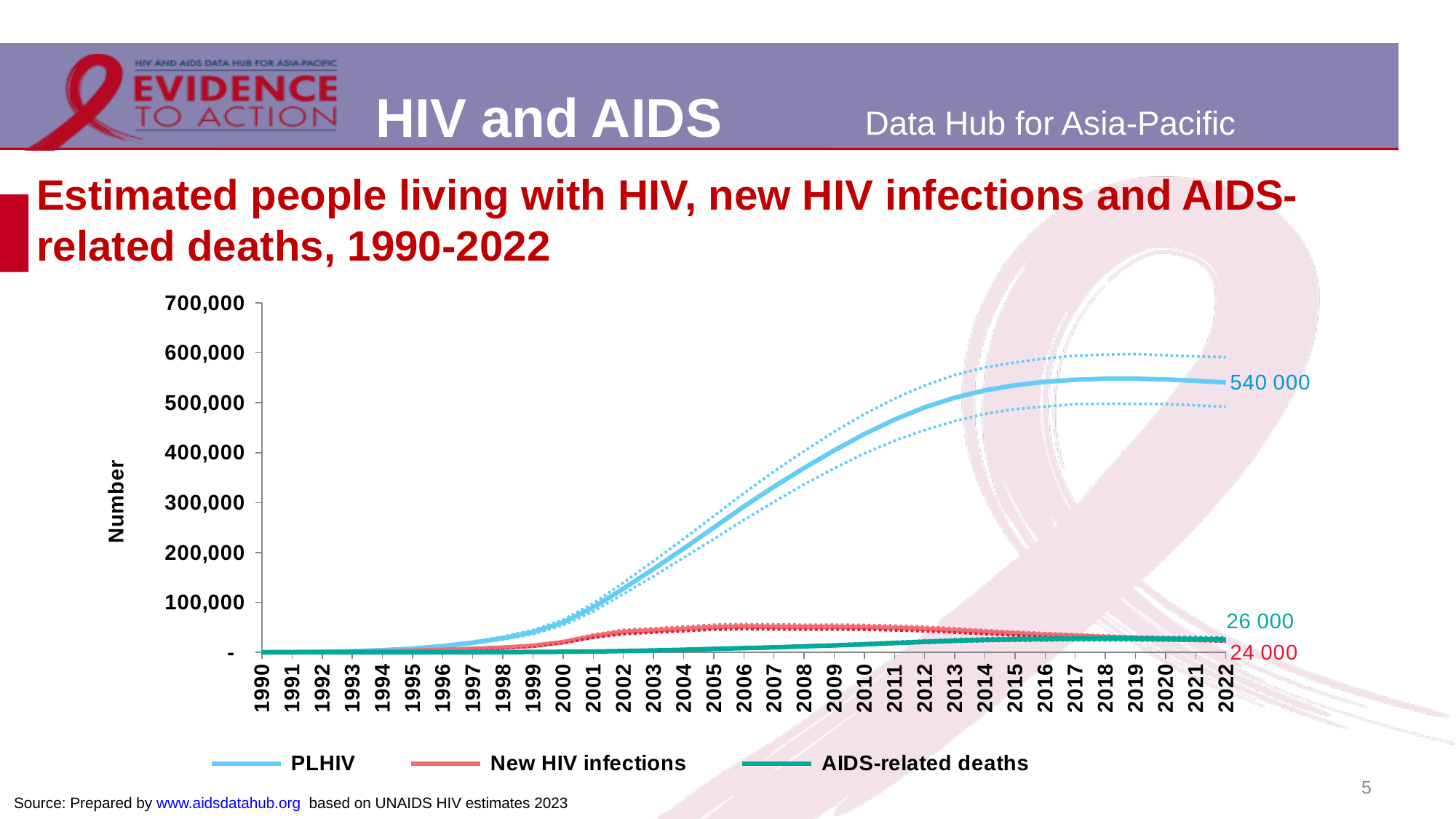
What is the value for New HIV infections in 2022? 24 000 Which series has the highest value in 2022? PLHIV What is the difference between PLHIV and AIDS-related deaths in 2022? 514 000 What is the value for PLHIV in 2022? 540 000 Does the PLHIV line rise or fall from 1990 to 2022? rise How many years are shown on the x axis? 33 Is the value for PLHIV in 2000 greater or less than 100,000? less How many series does the legend list? 3 Is the value for New HIV infections in 2006 greater or less than 100,000? less What kind of chart is shown on the slide? line chart In 2022, which is larger: AIDS-related deaths or New HIV infections? AIDS-related deaths What is the value for AIDS-related deaths in 2022? 26 000